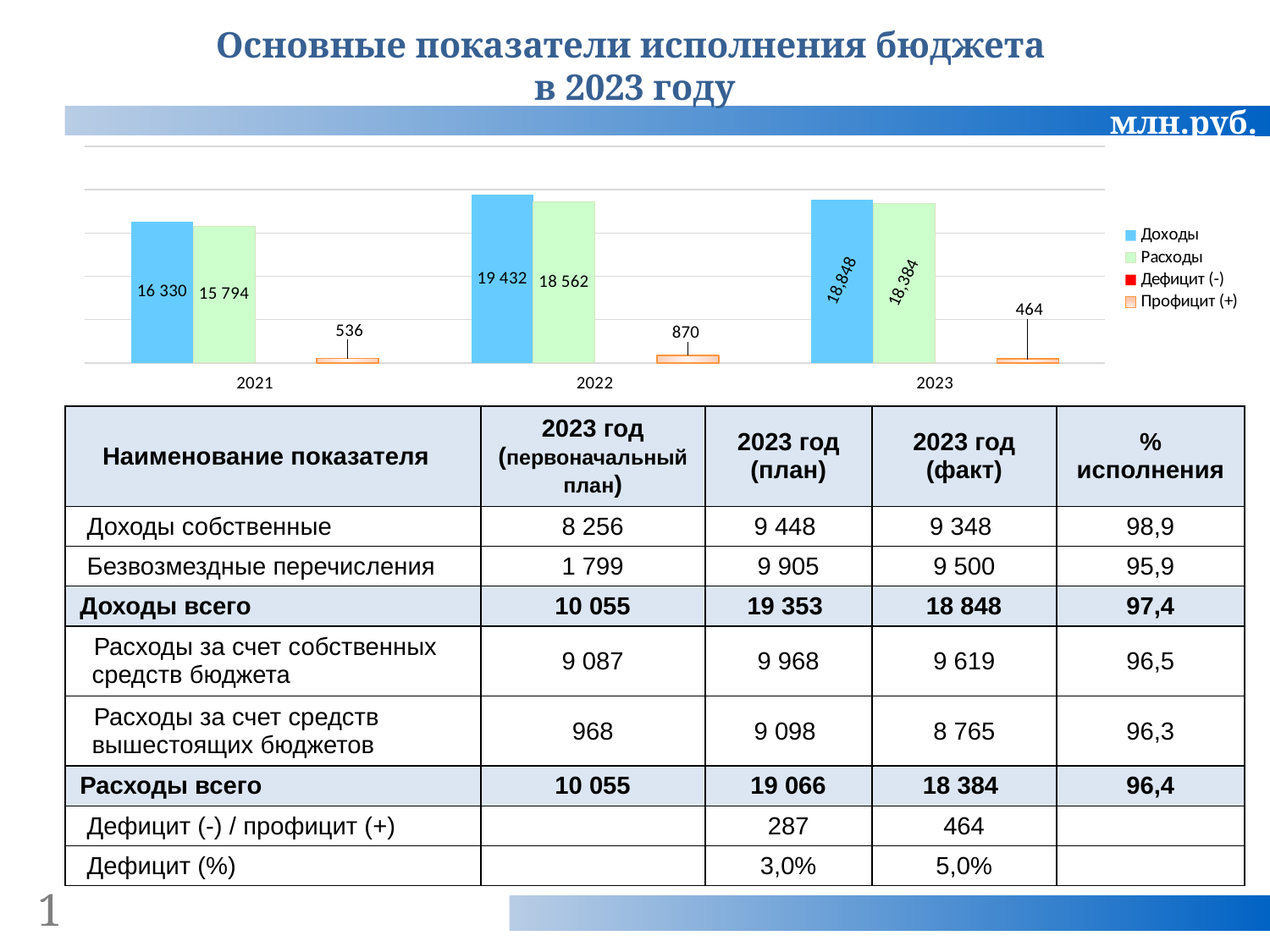
What is the value of Доходы for 2021 in the chart? 16 330 What unit is indicated for the chart values on the slide? млн.руб. Which is larger in the chart: Расходы for 2022 or Расходы for 2021? Расходы for 2022 What is the difference between Доходы and Расходы for 2021 in the chart? 536 What is the value of Расходы for 2022 in the chart? 18 562 In which year is Профицит (+) lowest in the chart? 2023 By how much does Профицит (+) in 2022 exceed Профицит (+) in 2021 in the chart? 334 What kind of chart is shown on the slide? Bar chart How many series does the chart legend list? 4 In which year is Доходы highest in the chart? 2022 What is the value of Профицит (+) for 2023 in the chart? 464 How many years are shown on the x axis of the chart? 3